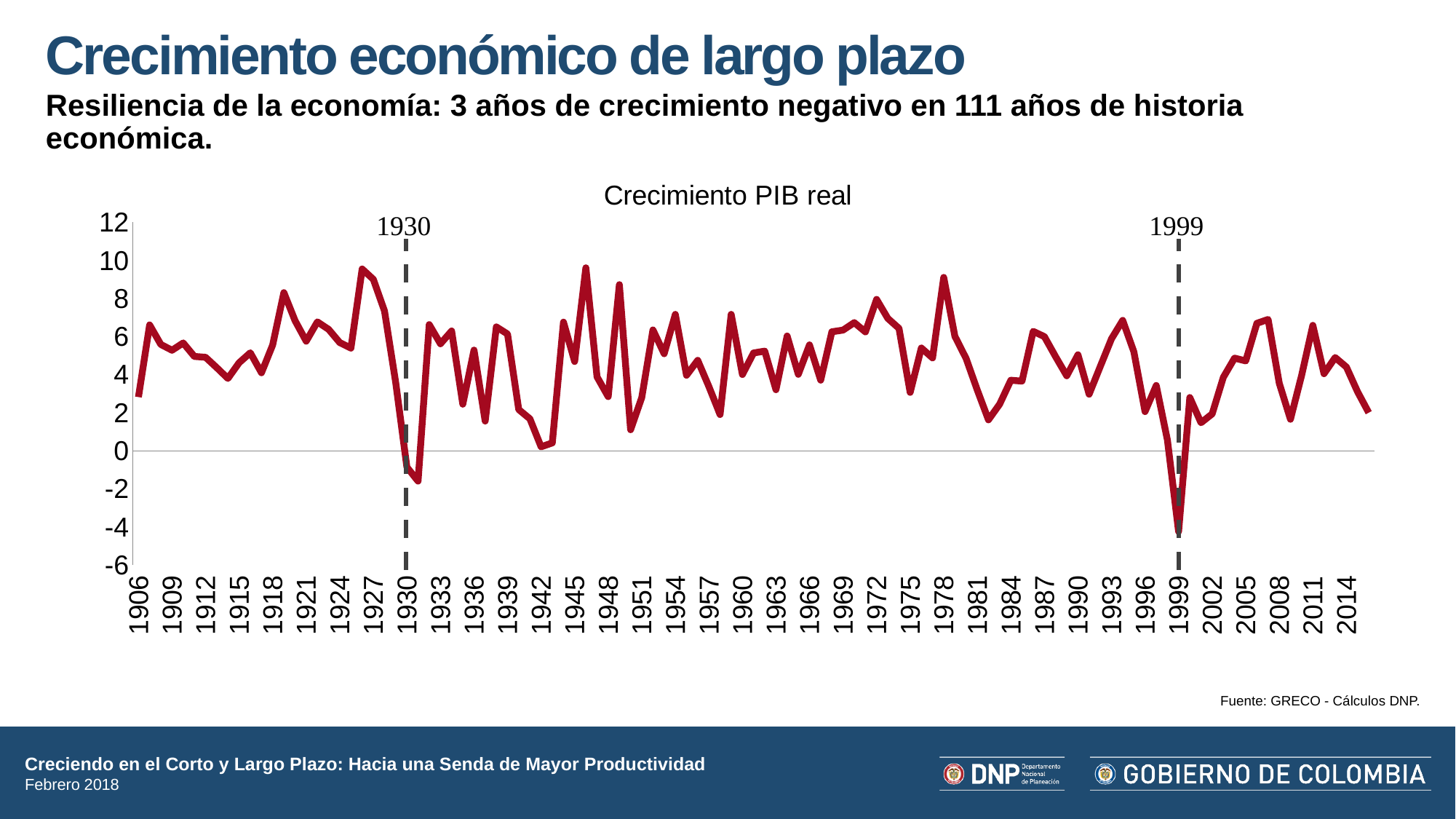
Which year has the lower value, 1931 or 1999? 1999 Is the value for 1978 greater or less than 8? greater Which year has the higher value, 1906 or 1928? 1928 What is the title of the chart? Crecimiento PIB real Is the value for 1942 greater or less than 2? less What kind of chart is shown on the slide? line chart Which year shows the lowest value of real GDP growth on the chart? 1999 Is the value for 1999 greater or less than -2? less Which two years are marked with vertical dashed lines on the chart? 1930 and 1999